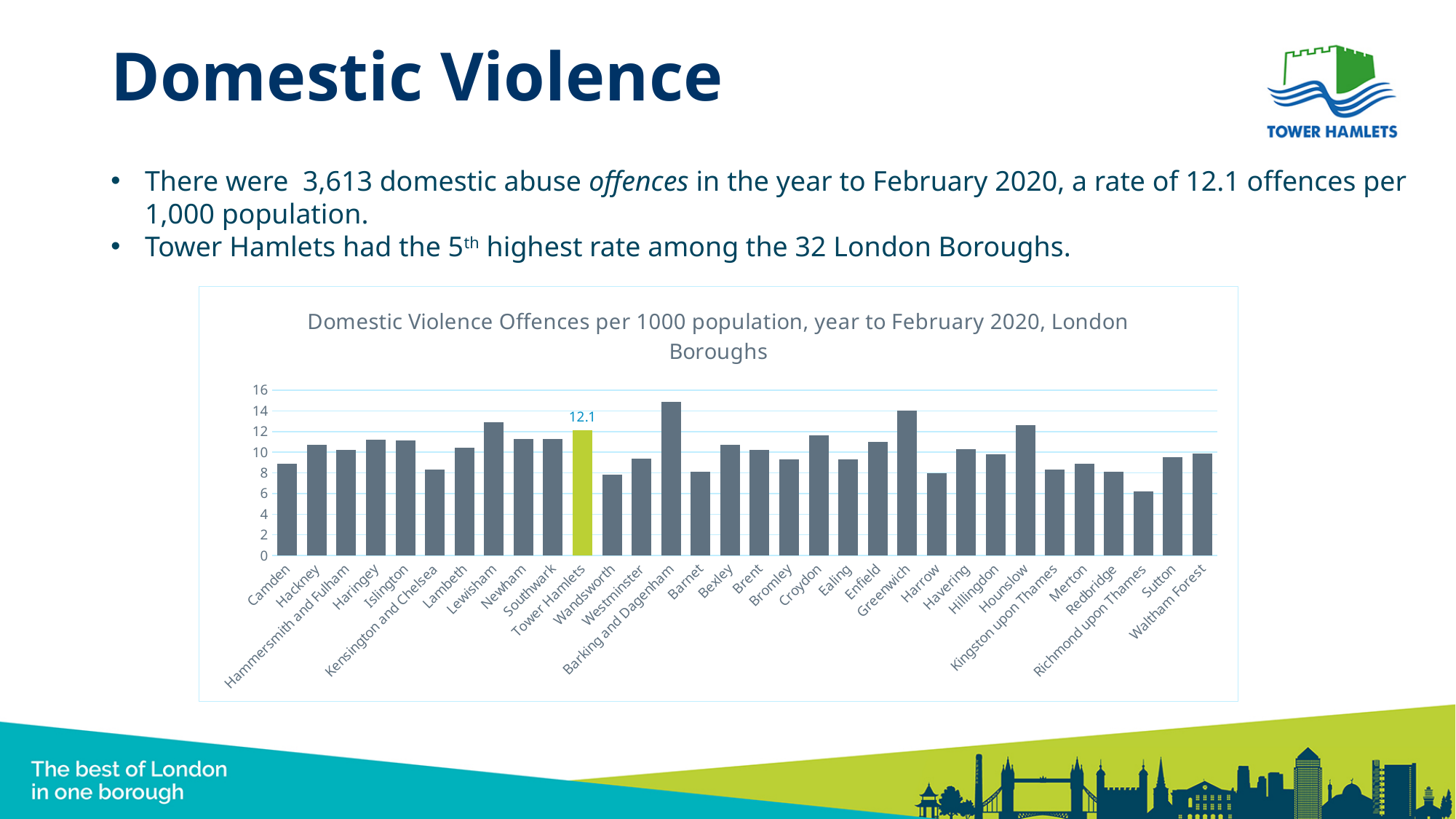
Is the value for Lewisham greater or less than 12? greater How many boroughs are shown in the chart? 32 Which borough has the highest domestic violence offences rate in the chart? Barking and Dagenham What kind of chart is shown on the slide? Bar chart Which has a higher value, Camden or Lewisham? Lewisham Is the value for Camden greater or less than 10? less Which borough's bar is highlighted in green in the chart? Tower Hamlets Is the value for Barking and Dagenham greater or less than 14? greater Which has a higher value, Greenwich or Harrow? Greenwich What is the value shown for Tower Hamlets in the chart? 12.1 Which borough has the lowest domestic violence offences rate in the chart? Richmond upon Thames